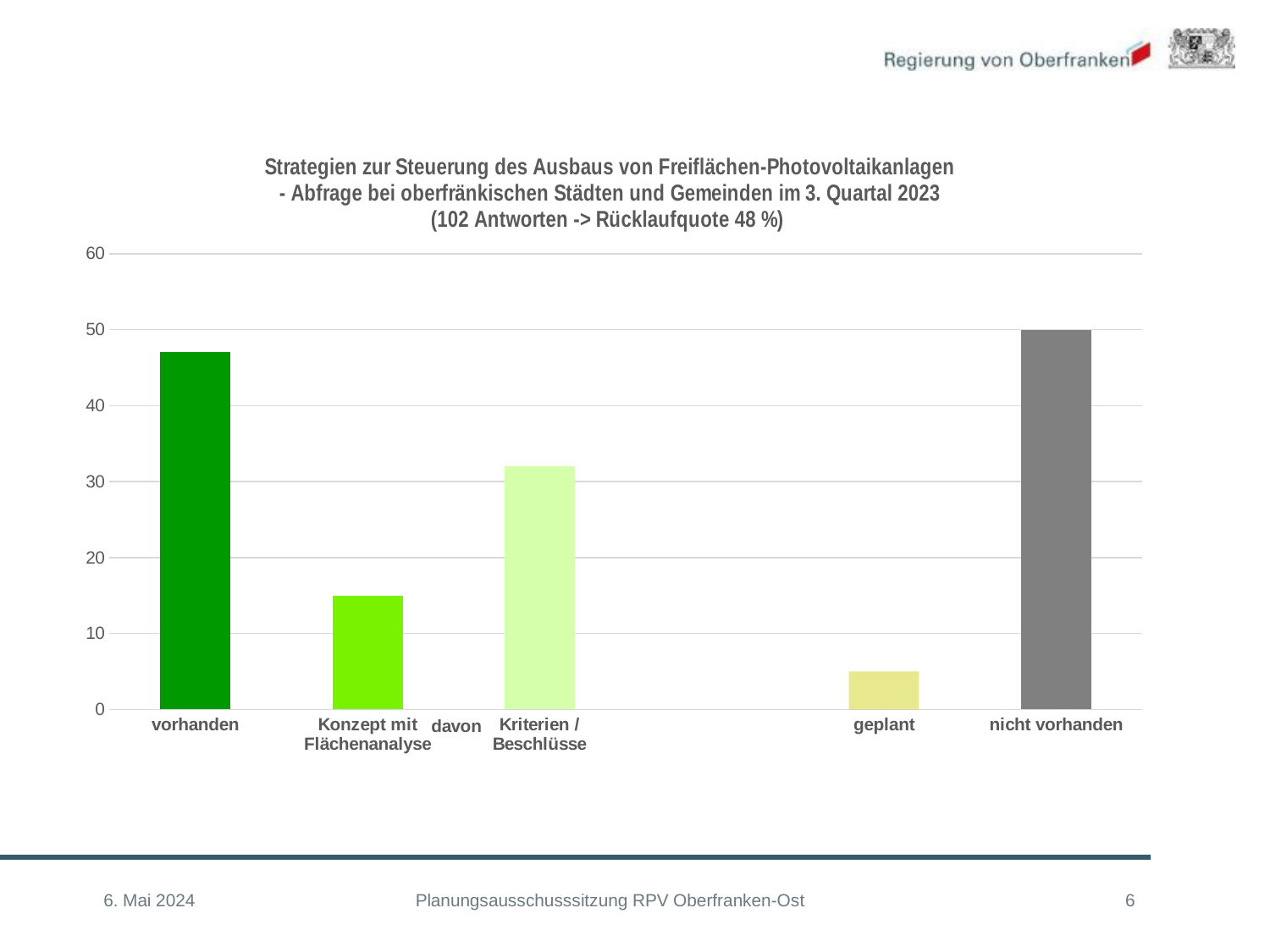
Is the value for 'Konzept mit Flächenanalyse' greater or less than 20? less Which is larger, the value for 'vorhanden' or the value for 'Kriterien / Beschlüsse'? vorhanden What is the value for 'nicht vorhanden'? 50 Which is larger, the value for 'Konzept mit Flächenanalyse' or the value for 'geplant'? Konzept mit Flächenanalyse Is the value for 'Kriterien / Beschlüsse' greater or less than 30? greater What kind of chart is shown on the slide? bar chart Which category has the highest bar? nicht vorhanden How many bars are plotted in the chart? 5 What colour is the bar for 'nicht vorhanden'? grey Is the value for 'vorhanden' greater or less than 40? greater Which category has the lowest bar? geplant